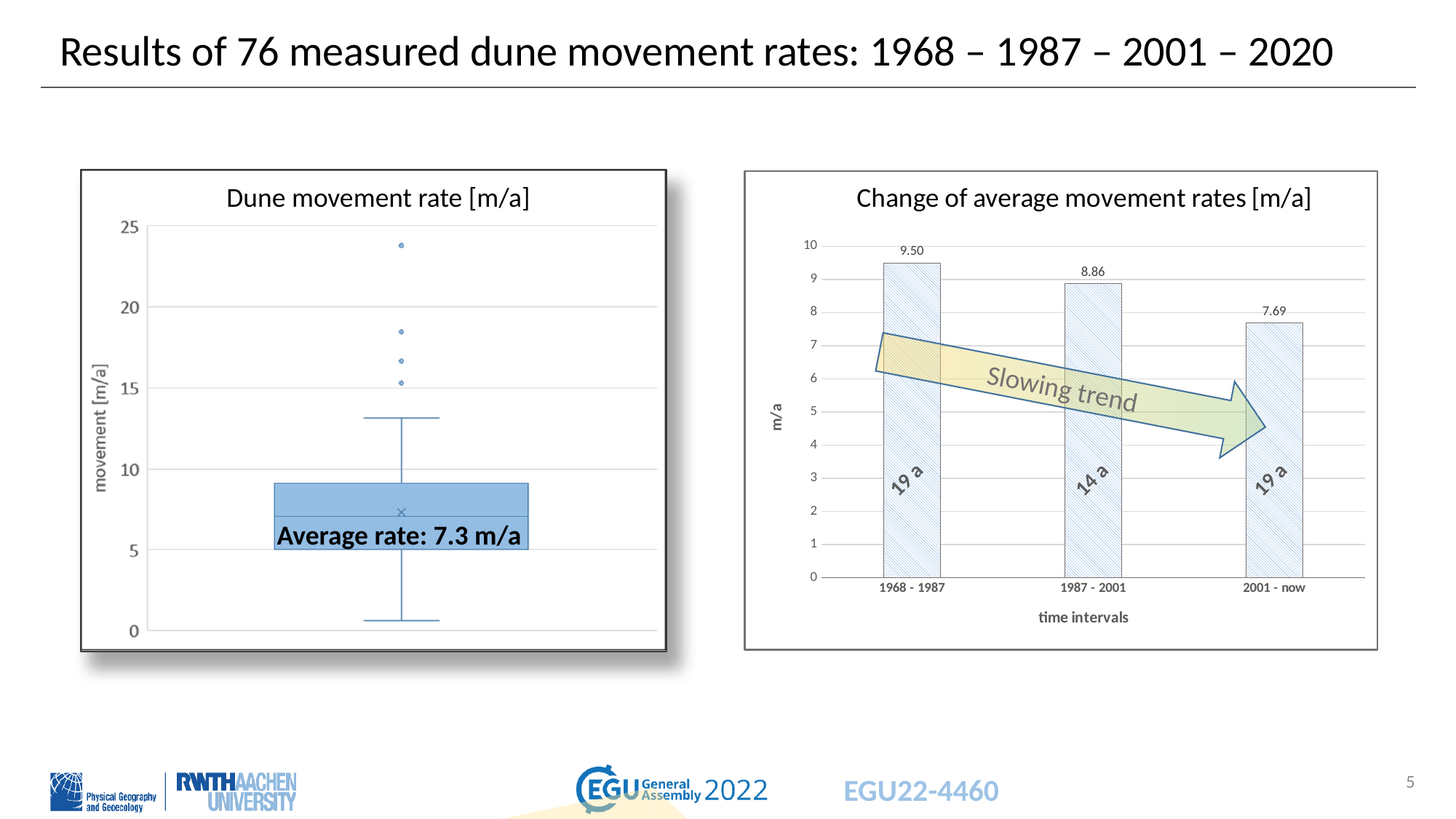
In the 'Change of average movement rates [m/a]' chart, what is the value for the 1968 - 1987 interval? 9.50 In the 'Change of average movement rates [m/a]' chart, which is larger: the value for 1987 - 2001 or the value for 2001 - now? 1987 - 2001 In the 'Change of average movement rates [m/a]' chart, which time interval has the highest average movement rate? 1968 - 1987 In the 'Change of average movement rates [m/a]' chart, what is the value for the 2001 - now interval? 7.69 In the 'Change of average movement rates [m/a]' chart, do the values rise or fall from left to right along the x axis? fall In the 'Dune movement rate [m/a]' chart on the left, what is the average rate stated on the chart? 7.3 m/a In the 'Change of average movement rates [m/a]' chart, how many time intervals are shown? 3 What is the x-axis label of the 'Change of average movement rates [m/a]' chart? time intervals What kind of chart is the 'Change of average movement rates [m/a]' chart? bar chart In the 'Change of average movement rates [m/a]' chart, what is the difference between the values for 1968 - 1987 and 2001 - now? 1.81 In the 'Change of average movement rates [m/a]' chart, what is the value for the 1987 - 2001 interval? 8.86 In the 'Change of average movement rates [m/a]' chart, which time interval has the lowest average movement rate? 2001 - now